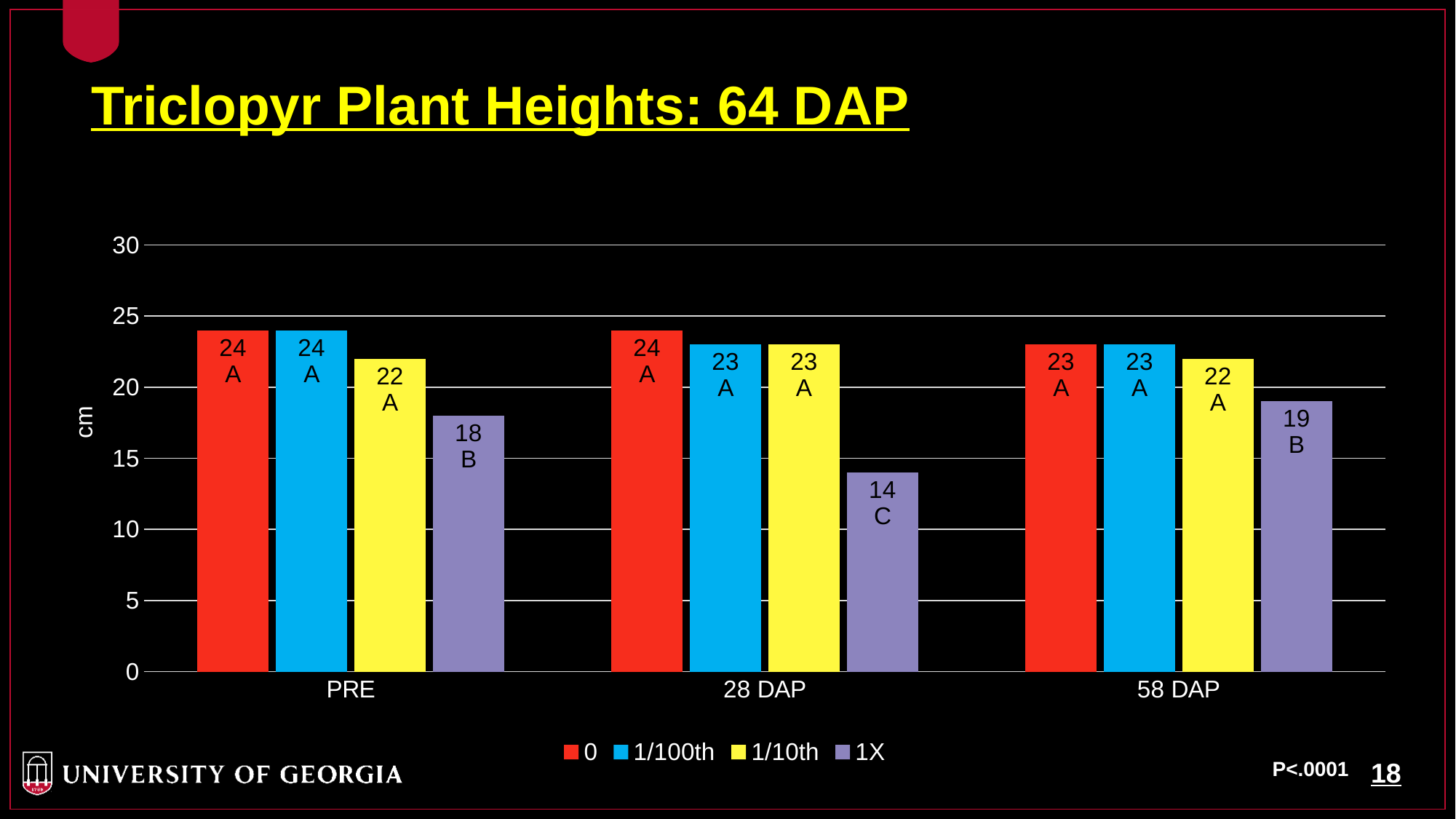
Which series has the lowest plant height at 28 DAP? 1X What is the plant height for the 1/10th series at PRE? 22 What is the difference between the 0 series and the 1X series at PRE? 6 Which series has the highest plant height at 28 DAP? 0 What is the difference between the 1/10th series and the 1X series at 28 DAP? 9 What is the plant height for the 0 series at 58 DAP? 23 What is the plant height for the 1X series at 28 DAP? 14 How many categories are shown on the x axis? 3 What is the label on the y axis? cm What kind of chart is shown on the slide? bar chart How many series does the legend list? 4 Which is larger, the 1X value at PRE or the 1X value at 58 DAP? 58 DAP